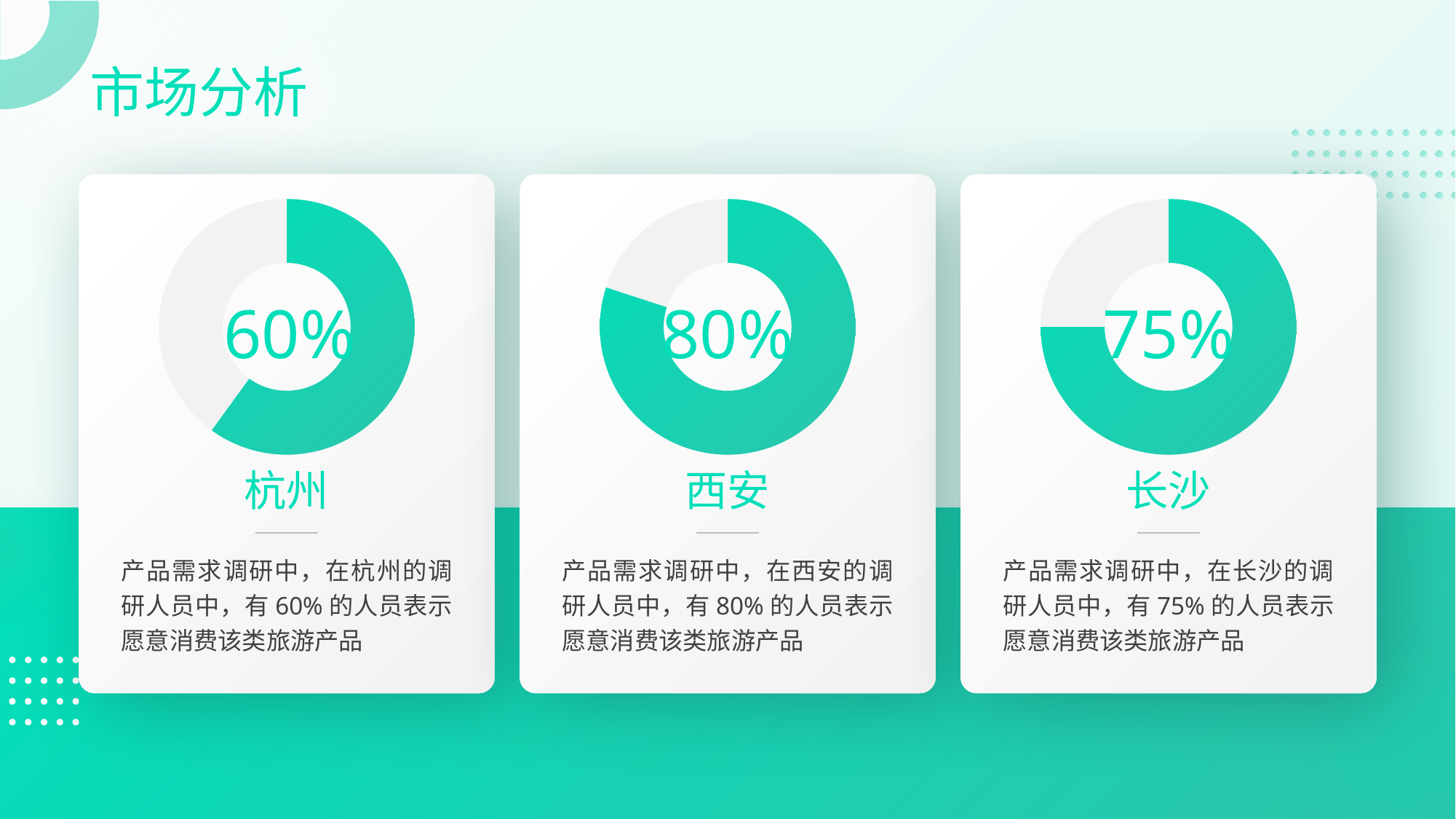
How many donut charts are on the slide? 3 Which city's donut chart shows the highest percentage? 西安 What kind of chart is used for each city on the slide? Donut chart What is the difference between the percentage for 西安 and the percentage for 杭州? 20% What percentage is shown in the donut chart for 杭州? 60% What is the difference between the percentage for 长沙 and the percentage for 杭州? 15% What percentage is shown in the donut chart for 长沙? 75% Which city's donut chart shows the lowest percentage? 杭州 What is the title of the slide containing the three donut charts? 市场分析 What percentage is shown in the donut chart for 西安? 80% Which is larger, the percentage for 西安 or the percentage for 长沙? 西安 Which is larger, the percentage for 长沙 or the percentage for 杭州? 长沙